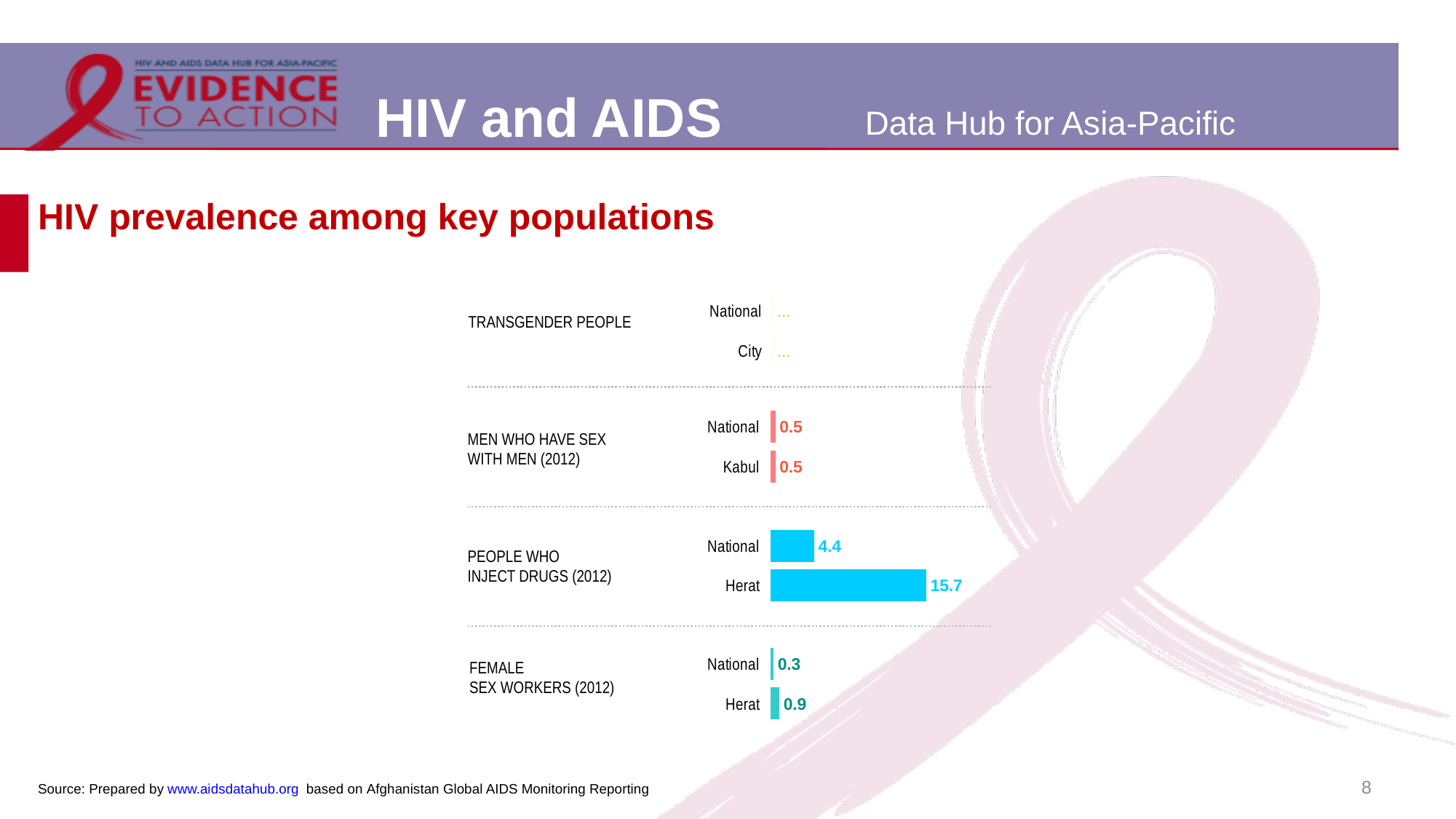
What is the HIV prevalence among female sex workers in Herat? 0.9 How many key population groups are shown on the chart? 4 What is the national HIV prevalence among female sex workers (2012)? 0.3 Which bar shows the highest HIV prevalence value on the chart? People who inject drugs, Herat What is the national HIV prevalence among people who inject drugs (2012)? 4.4 Which is larger: the national HIV prevalence among people who inject drugs or the national prevalence among female sex workers? People who inject drugs What is the HIV prevalence among people who inject drugs in Herat? 15.7 What type of chart is used to show HIV prevalence among key populations? Bar chart What is the difference between the Herat and national HIV prevalence among female sex workers? 0.6 What is the difference between the Herat and national HIV prevalence among people who inject drugs? 11.3 What is the HIV prevalence among men who have sex with men in Kabul? 0.5 What value is shown for transgender people at the national level? ...